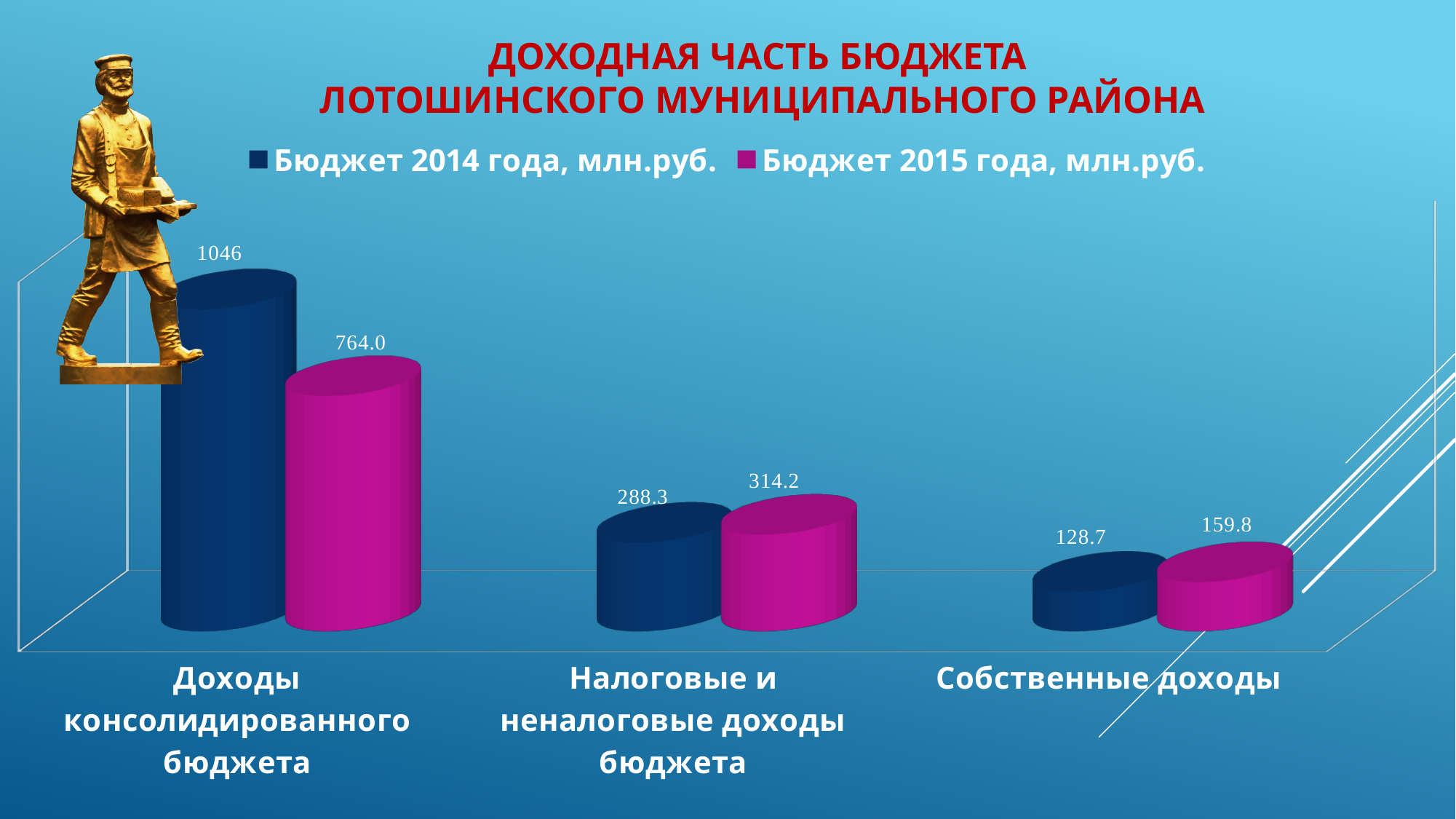
What is the value for Собственные доходы in the Бюджет 2014 года series? 128.7 What is the value for Доходы консолидированного бюджета in the Бюджет 2015 года series? 764.0 What is the difference between the Бюджет 2015 года and Бюджет 2014 года values for Собственные доходы? 31.1 How many series does the legend list? 2 What is the difference between the Бюджет 2014 года and Бюджет 2015 года values for Доходы консолидированного бюджета? 282.0 Which category has the highest value in the Бюджет 2014 года series? Доходы консолидированного бюджета What is the value for Налоговые и неналоговые доходы бюджета in the Бюджет 2015 года series? 314.2 What kind of chart is shown on the slide? Bar chart For Налоговые и неналоговые доходы бюджета, which series has the larger value, Бюджет 2014 года or Бюджет 2015 года? Бюджет 2015 года Which category has the lowest value in the Бюджет 2015 года series? Собственные доходы What is the value for Доходы консолидированного бюджета in the Бюджет 2014 года series? 1046 How many categories are shown on the x axis of the chart? 3